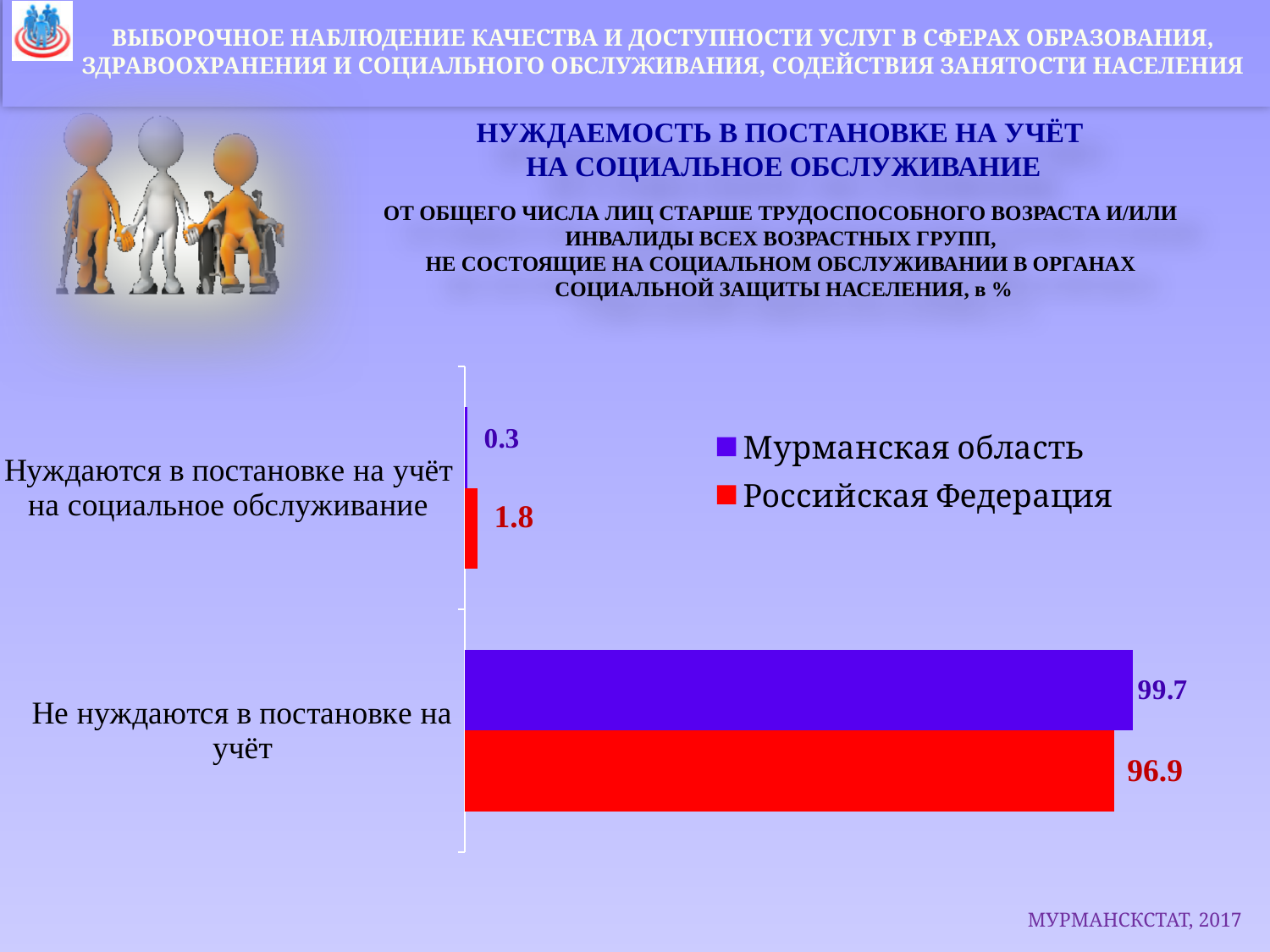
Which category has the lowest value for Российская Федерация? Нуждаются в постановке на учёт на социальное обслуживание What kind of chart is shown on the slide? Bar chart In the category 'Не нуждаются в постановке на учёт', which series has the larger value: Мурманская область or Российская Федерация? Мурманская область What is the value for Российская Федерация in the category 'Не нуждаются в постановке на учёт'? 96.9 What is the difference between the Мурманская область and Российская Федерация values in the category 'Не нуждаются в постановке на учёт'? 2.8 How many series does the legend list? 2 Which category has the highest value for Мурманская область? Не нуждаются в постановке на учёт How many categories are shown on the chart? 2 What is the value for Мурманская область in the category 'Нуждаются в постановке на учёт на социальное обслуживание'? 0.3 What is the value for Мурманская область in the category 'Не нуждаются в постановке на учёт'? 99.7 What is the difference between the Российская Федерация and Мурманская область values in the category 'Нуждаются в постановке на учёт на социальное обслуживание'? 1.5 What is the value for Российская Федерация in the category 'Нуждаются в постановке на учёт на социальное обслуживание'? 1.8